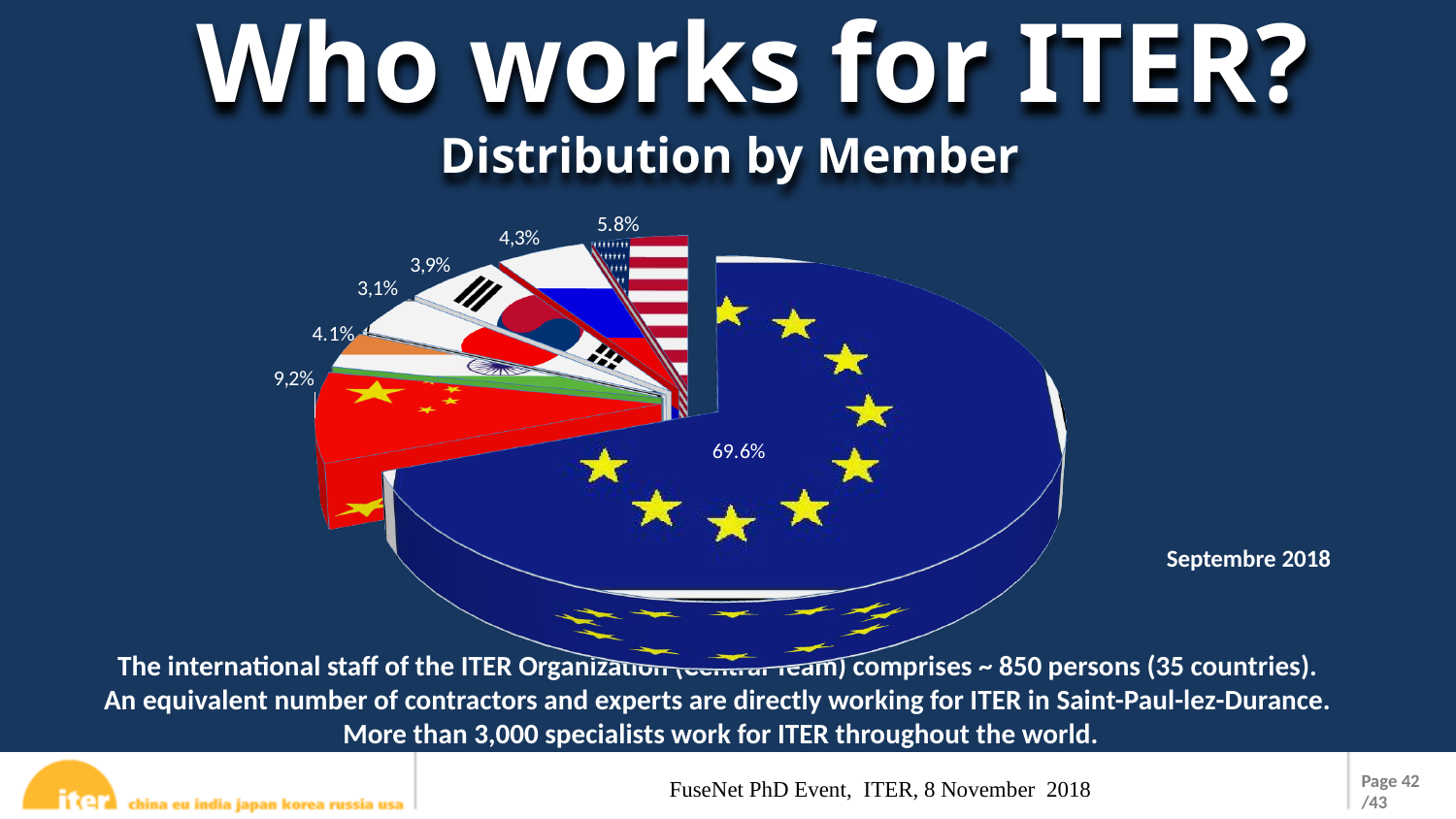
What is the smallest percentage labelled on the pie chart? 3,1% Which slice has the largest share of the pie? the EU flag slice (69.6%) What percentage is shown for the slice with the Indian flag? 4.1% What is the title of the chart on the slide? Distribution by Member What kind of chart is shown on the slide? pie chart Which is larger, the slice with the Chinese flag or the slice with the US flag? the Chinese flag slice What date is given next to the pie chart? Septembre 2018 How many slices does the pie chart have? 7 What percentage is shown for the slice with the Chinese flag? 9,2% What percentage is shown for the largest slice (the one with the EU flag)? 69.6% What percentage is shown for the slice with the US flag? 5.8% What is the difference between the EU flag slice (69.6%) and the Chinese flag slice (9,2%)? 60.4%